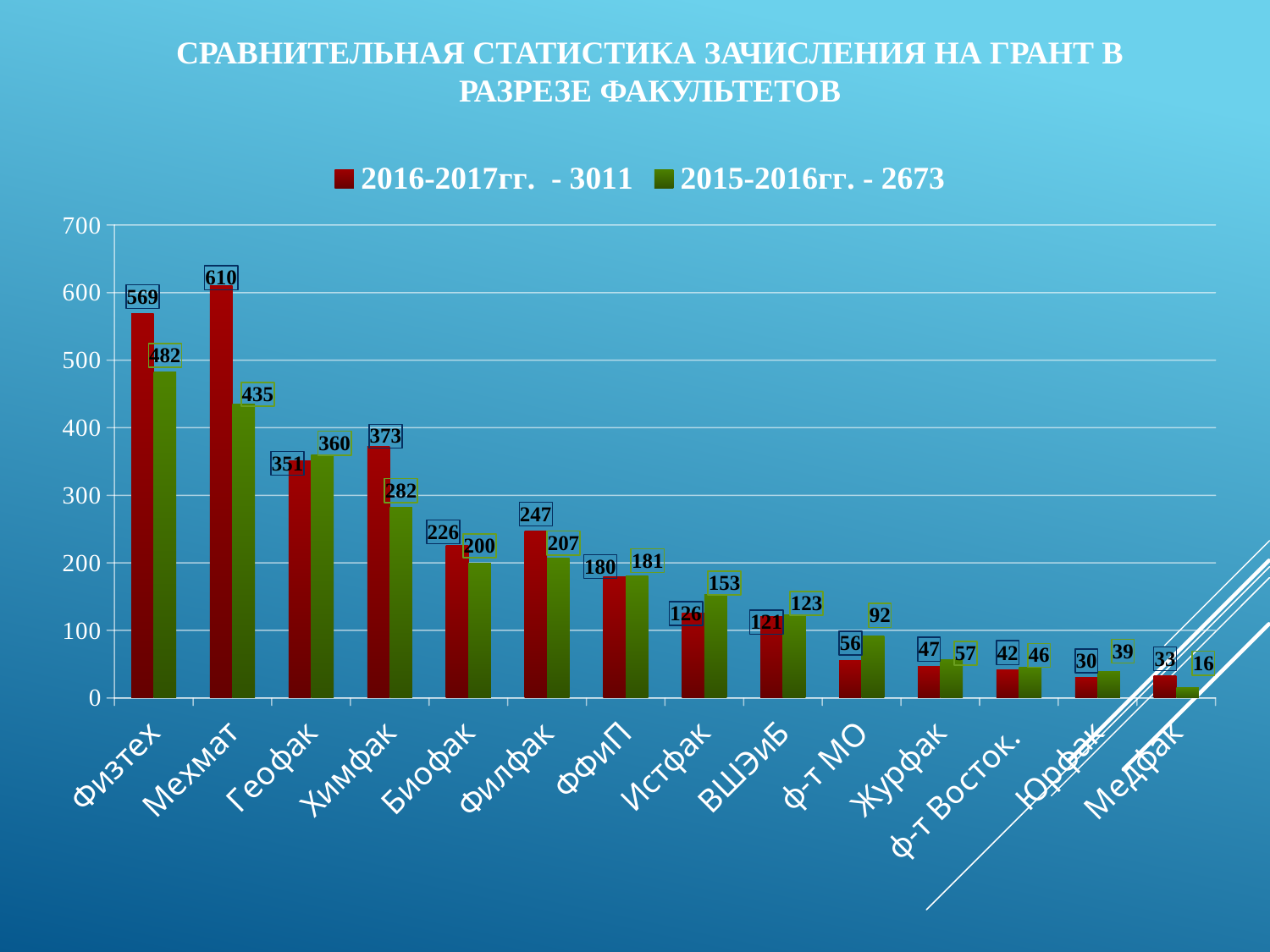
What type of chart is shown on the slide? bar chart Which faculty has the lowest value in the 2015-2016гг. series? Медфак How many faculties (categories) are shown on the x axis? 14 What is the difference between the 2016-2017гг. and 2015-2016гг. values for Химфак? 91 What is the value for Физтех in the 2015-2016гг. series? 482 What is the value for ф-т МО in the 2015-2016гг. series? 92 For Истфак, which series has the larger value, 2016-2017гг. or 2015-2016гг.? 2015-2016гг. How many series does the legend list? 2 Which colour represents the 2015-2016гг. series in the legend? green What is the value for Мехмат in the 2016-2017гг. series? 610 Which faculty has the highest value in the 2016-2017гг. series? Мехмат Is the 2016-2017гг. value for Геофак greater or less than 300? greater